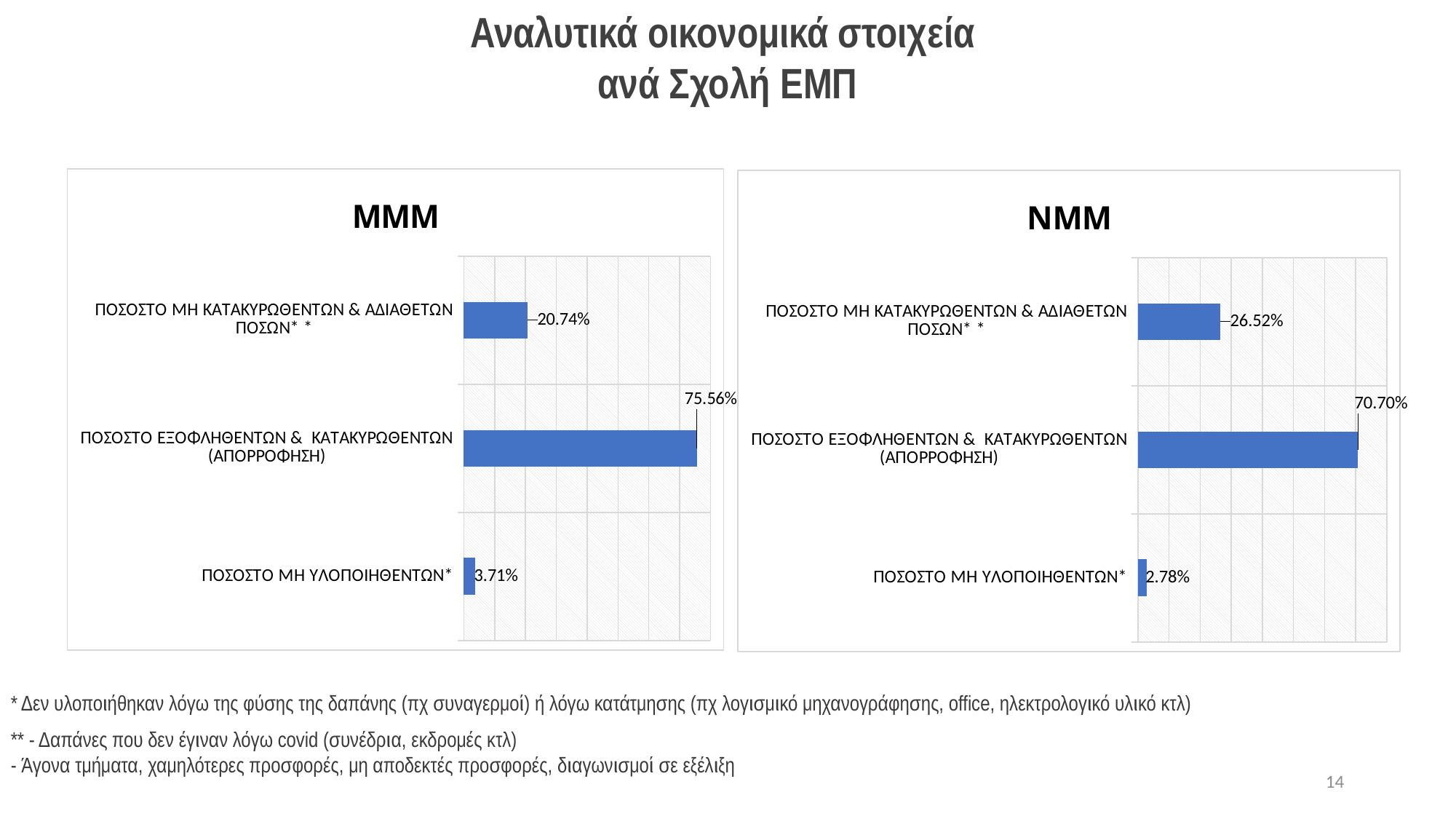
In the MMM chart, what is the value for ΠΟΣΟΣΤΟ ΕΞΟΦΛΗΘΕΝΤΩΝ & ΚΑΤΑΚΥΡΩΘΕΝΤΩΝ (ΑΠΟΡΡΟΦΗΣΗ)? 75.56% What is the difference between the ΠΟΣΟΣΤΟ ΕΞΟΦΛΗΘΕΝΤΩΝ & ΚΑΤΑΚΥΡΩΘΕΝΤΩΝ (ΑΠΟΡΡΟΦΗΣΗ) value in the MMM chart and the same category in the NMM chart? 4.86% How many categories does the NMM chart show? 3 In the NMM chart, what is the value for ΠΟΣΟΣΤΟ ΜΗ ΥΛΟΠΟΙΗΘΕΝΤΩΝ*? 2.78% In the MMM chart, what is the difference between ΠΟΣΟΣΤΟ ΕΞΟΦΛΗΘΕΝΤΩΝ & ΚΑΤΑΚΥΡΩΘΕΝΤΩΝ (ΑΠΟΡΡΟΦΗΣΗ) and ΠΟΣΟΣΤΟ ΜΗ ΚΑΤΑΚΥΡΩΘΕΝΤΩΝ & ΑΔΙΑΘΕΤΩΝ ΠΟΣΩΝ**? 54.82% In the MMM chart, which category has the lowest value? ΠΟΣΟΣΤΟ ΜΗ ΥΛΟΠΟΙΗΘΕΝΤΩΝ* In the NMM chart, which category has the highest value? ΠΟΣΟΣΤΟ ΕΞΟΦΛΗΘΕΝΤΩΝ & ΚΑΤΑΚΥΡΩΘΕΝΤΩΝ (ΑΠΟΡΡΟΦΗΣΗ) What kind of chart is the MMM chart? Bar chart In the MMM chart, what is the value for ΠΟΣΟΣΤΟ ΜΗ ΥΛΟΠΟΙΗΘΕΝΤΩΝ*? 3.71% Which is larger: ΠΟΣΟΣΤΟ ΜΗ ΚΑΤΑΚΥΡΩΘΕΝΤΩΝ & ΑΔΙΑΘΕΤΩΝ ΠΟΣΩΝ** in the MMM chart or in the NMM chart? NMM In the NMM chart, what is the value for ΠΟΣΟΣΤΟ ΜΗ ΚΑΤΑΚΥΡΩΘΕΝΤΩΝ & ΑΔΙΑΘΕΤΩΝ ΠΟΣΩΝ**? 26.52% What is the title of the chart on the right side of the slide? NMM